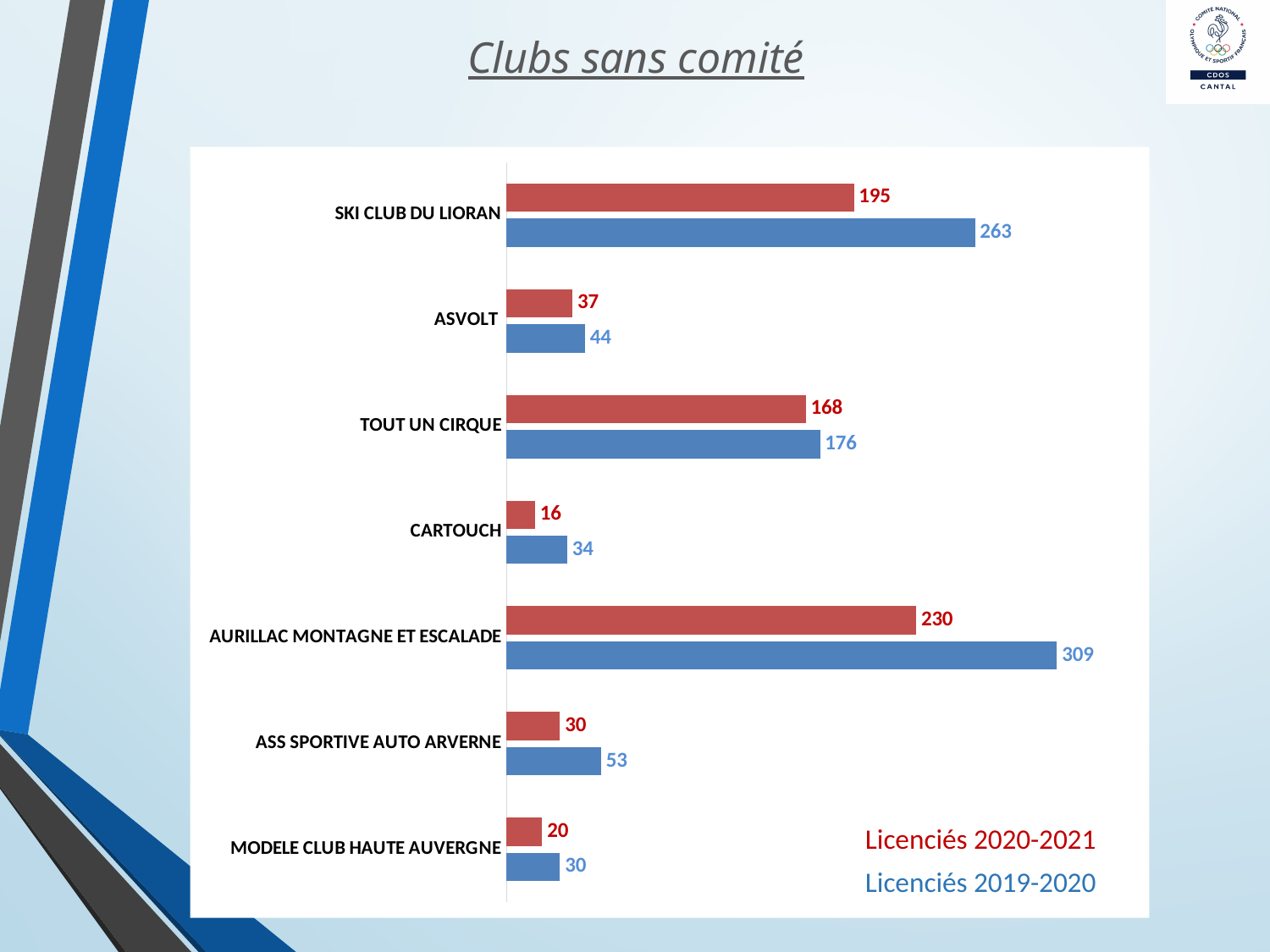
What is the difference between the Licenciés 2019-2020 and Licenciés 2020-2021 values for SKI CLUB DU LIORAN? 68 Which club has the highest value in the Licenciés 2019-2020 series? AURILLAC MONTAGNE ET ESCALADE Which is larger for TOUT UN CIRQUE: the Licenciés 2020-2021 value or the Licenciés 2019-2020 value? Licenciés 2019-2020 How many series does the legend list? 2 What is the difference between the Licenciés 2019-2020 and Licenciés 2020-2021 values for AURILLAC MONTAGNE ET ESCALADE? 79 How many clubs are shown in the chart? 7 What is the value for CARTOUCH in the Licenciés 2020-2021 series? 16 What is the value for AURILLAC MONTAGNE ET ESCALADE in the Licenciés 2019-2020 series? 309 What kind of chart is shown on the slide? Bar chart Which club has the lowest value in the Licenciés 2020-2021 series? CARTOUCH What is the title of the slide? Clubs sans comité What is the value for SKI CLUB DU LIORAN in the Licenciés 2020-2021 series? 195